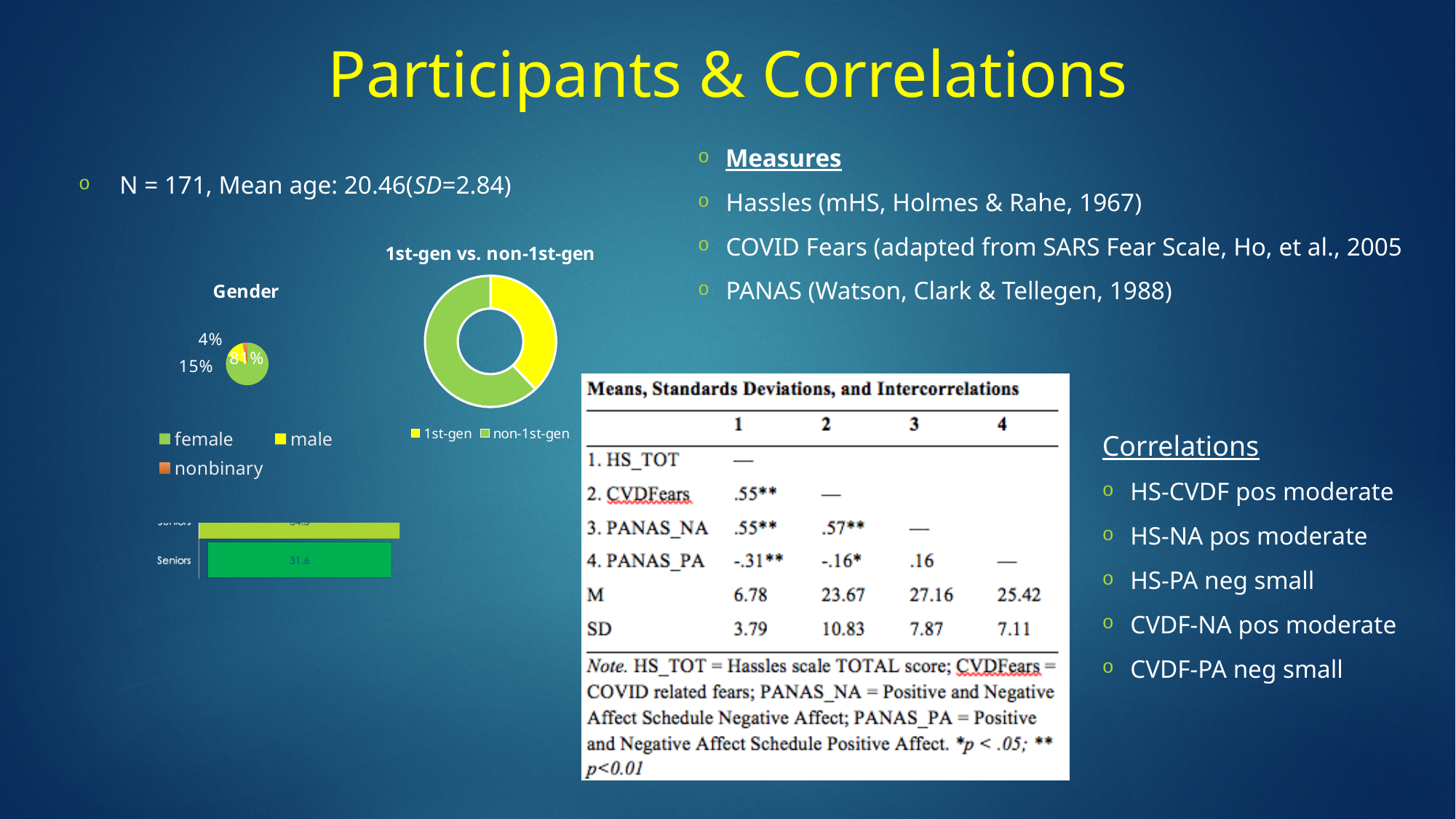
In the Gender chart, which category has the smallest share? nonbinary In the Gender chart, what percentage is male? 15% What kind of chart is the '1st-gen vs. non-1st-gen' chart? doughnut chart In the '1st-gen vs. non-1st-gen' chart, which category has the larger share? non-1st-gen How many categories does the legend of the '1st-gen vs. non-1st-gen' chart list? 2 How many categories does the legend of the Gender chart list? 3 In the Gender chart, what percentage is nonbinary? 4% In the bar chart at the bottom left, what is the value for Seniors? 31.6 What kind of chart is the Gender chart? pie chart In the Gender chart, what is the difference between the male and nonbinary percentages? 11% In the Gender chart, what percentage is female? 81% In the Gender chart, which category has the largest share? female